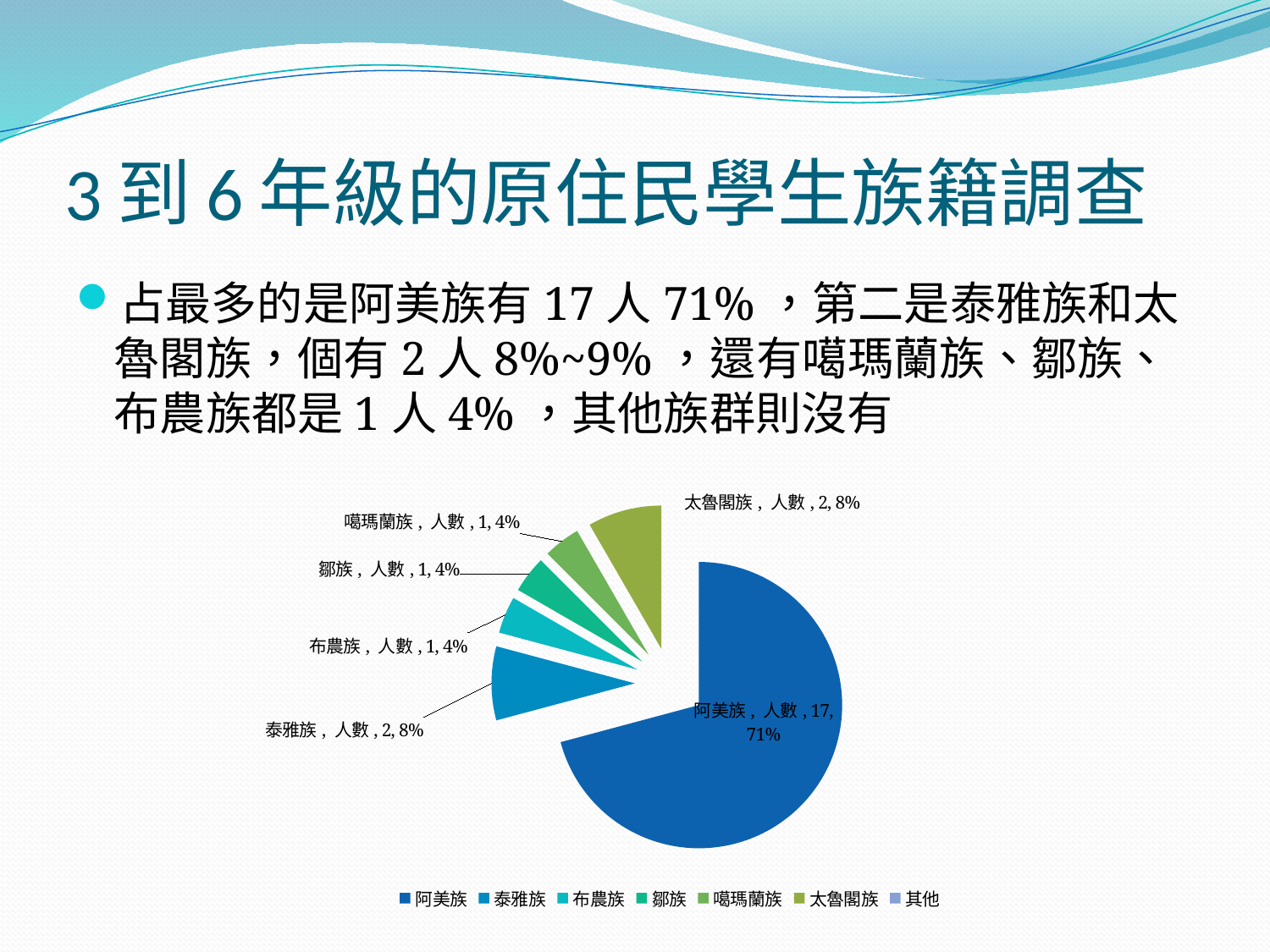
What is the value (人數) for 泰雅族 in the pie chart? 2 Which group has the largest slice in the pie chart? 阿美族 How many entries does the legend of the pie chart list? 7 What percentage share does 阿美族 have in the pie chart? 71% What colour is the 阿美族 slice in the pie chart? Dark blue What is the difference in 人數 between 阿美族 and 泰雅族? 15 How many people are in the 阿美族 slice of the pie chart? 17 What is the value (人數) for 布農族 in the pie chart? 1 What type of chart is shown on the slide? Pie chart What percentage share does 太魯閣族 have in the pie chart? 8% Which has a larger value, 太魯閣族 or 鄒族? 太魯閣族 What percentage share does 噶瑪蘭族 have in the pie chart? 4%